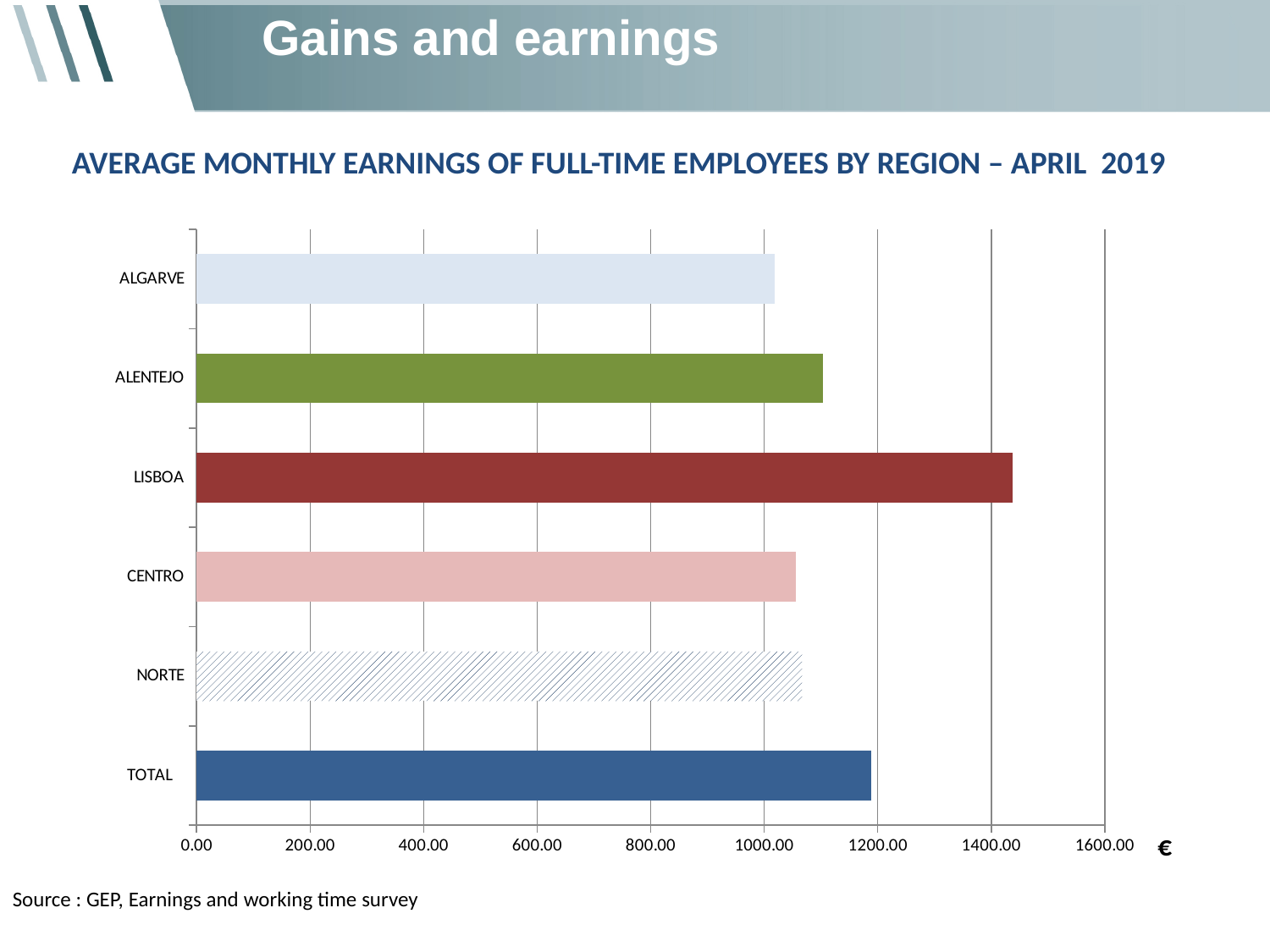
What kind of chart is shown on the slide? bar chart Is the value for TOTAL greater or less than 1000.00? greater Which is larger, the value for LISBOA or the value for TOTAL? LISBOA Is the value for ALGARVE greater or less than 1200.00? less Which region has the highest average monthly earnings? LISBOA Is the value for CENTRO greater or less than 1200.00? less What unit symbol is shown at the end of the horizontal axis? € What is the title of the chart? AVERAGE MONTHLY EARNINGS OF FULL-TIME EMPLOYEES BY REGION – APRIL 2019 How many categories are plotted on the chart? 6 Which is larger, the value for ALENTEJO or the value for ALGARVE? ALENTEJO